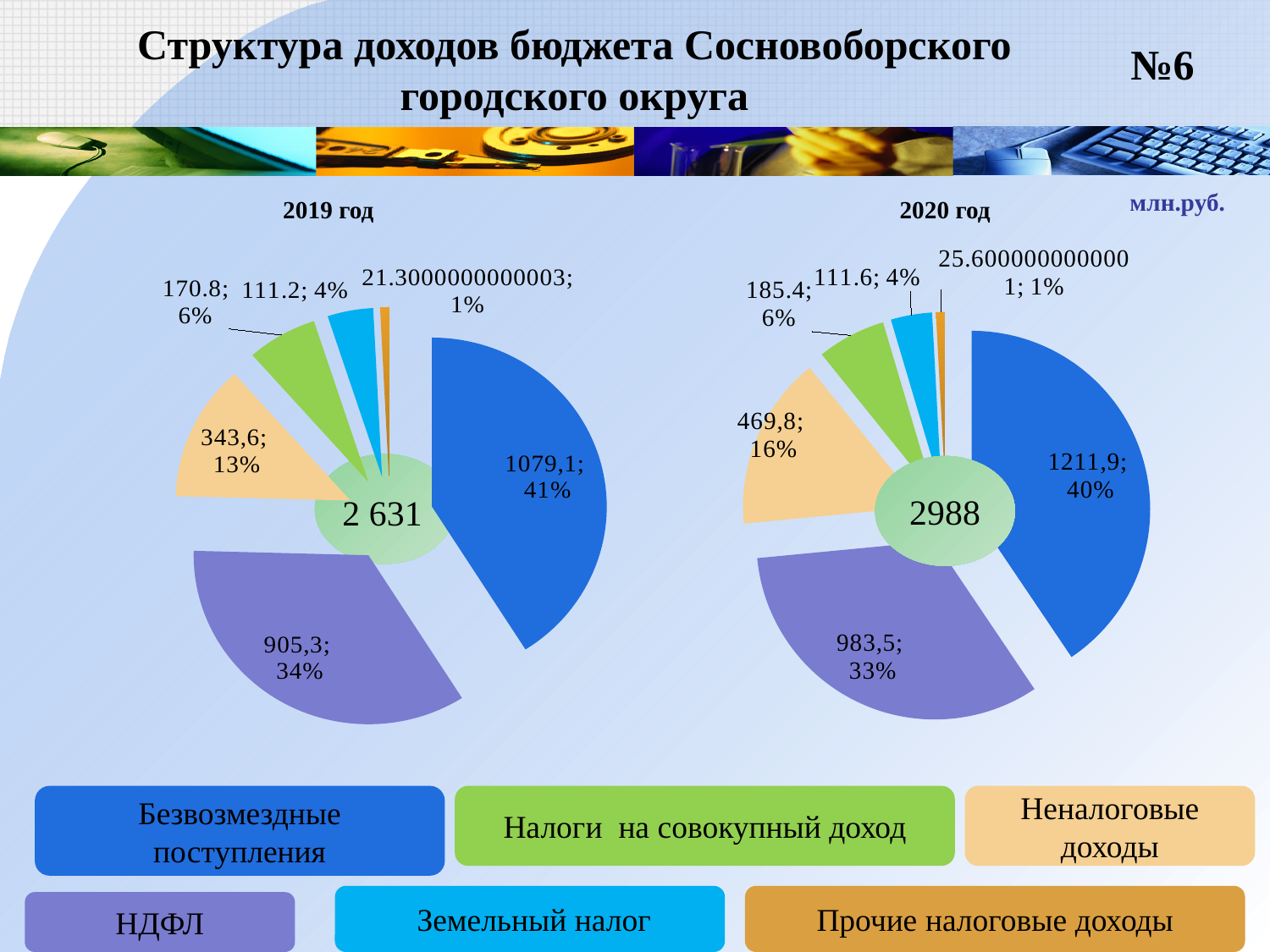
On the 2019 год pie chart, which category has the largest slice? Безвозмездные поступления On the 2020 год pie chart, what is the difference between Безвозмездные поступления and НДФЛ? 228,4 On the 2020 год pie chart, what is the value for НДФЛ? 983,5 How many slices does the 2020 год pie chart have? 6 On the 2020 год pie chart, which category has the smallest slice? Прочие налоговые доходы On the 2020 год pie chart, what share of the pie is Неналоговые доходы? 16% On the 2019 год pie chart, what is the value for Безвозмездные поступления? 1079,1 On the 2019 год pie chart, which is larger: Неналоговые доходы or Налоги на совокупный доход? Неналоговые доходы What total is shown in the centre of the 2020 год pie chart? 2988 What colour represents Земельный налог in the legend? Light blue On the 2019 год pie chart, what share of the pie is НДФЛ? 34% What type of chart is used for 2019 год? Pie chart